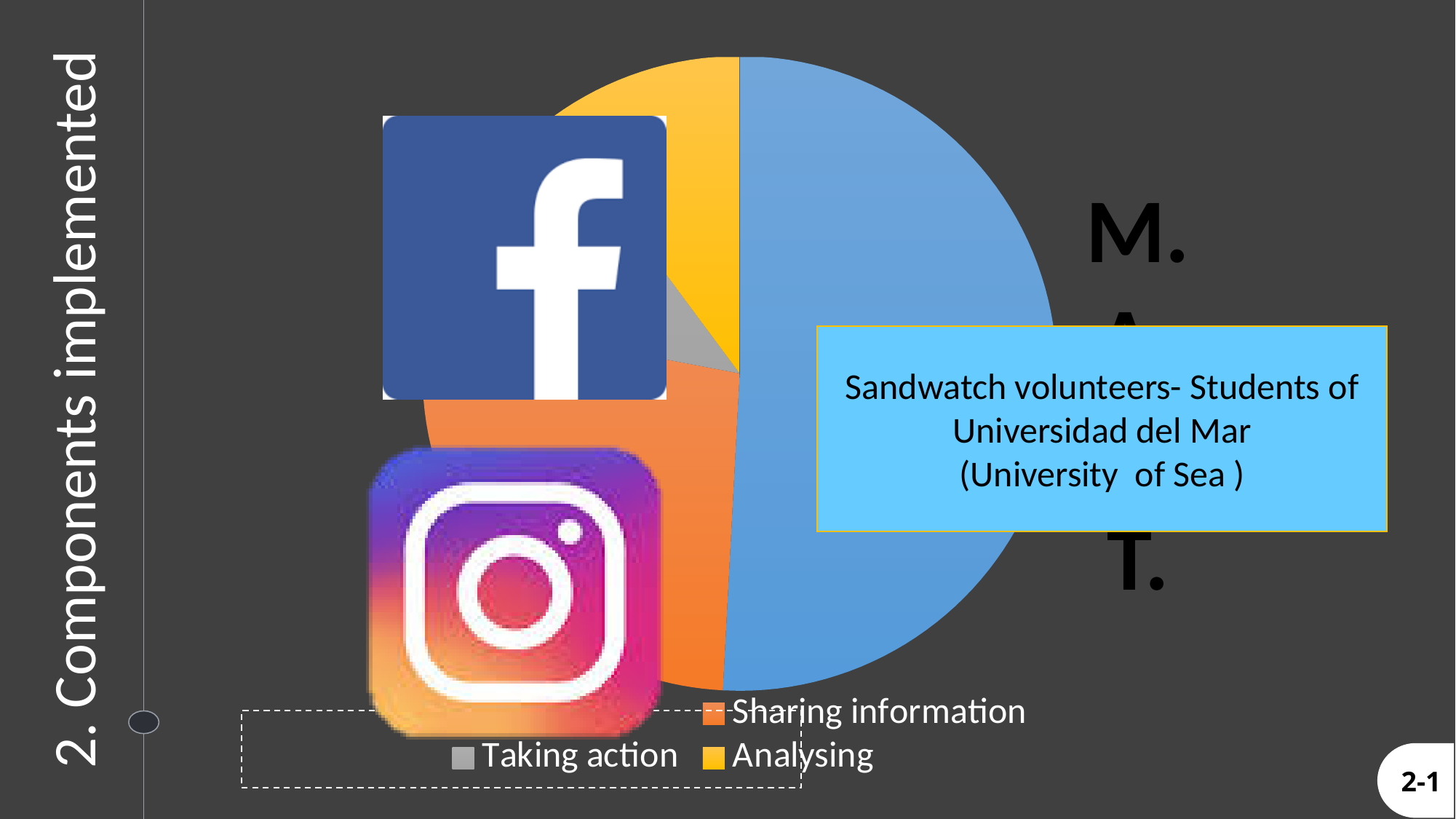
What kind of chart is shown on the slide? pie chart What colour is the Sharing information slice in the pie chart? orange Which is larger in the pie chart, Sharing information or Taking action? Sharing information What colour is the Analysing slice in the pie chart? yellow Which is larger in the pie chart, Sharing information or Analysing? Sharing information How many slices does the pie chart have? 4